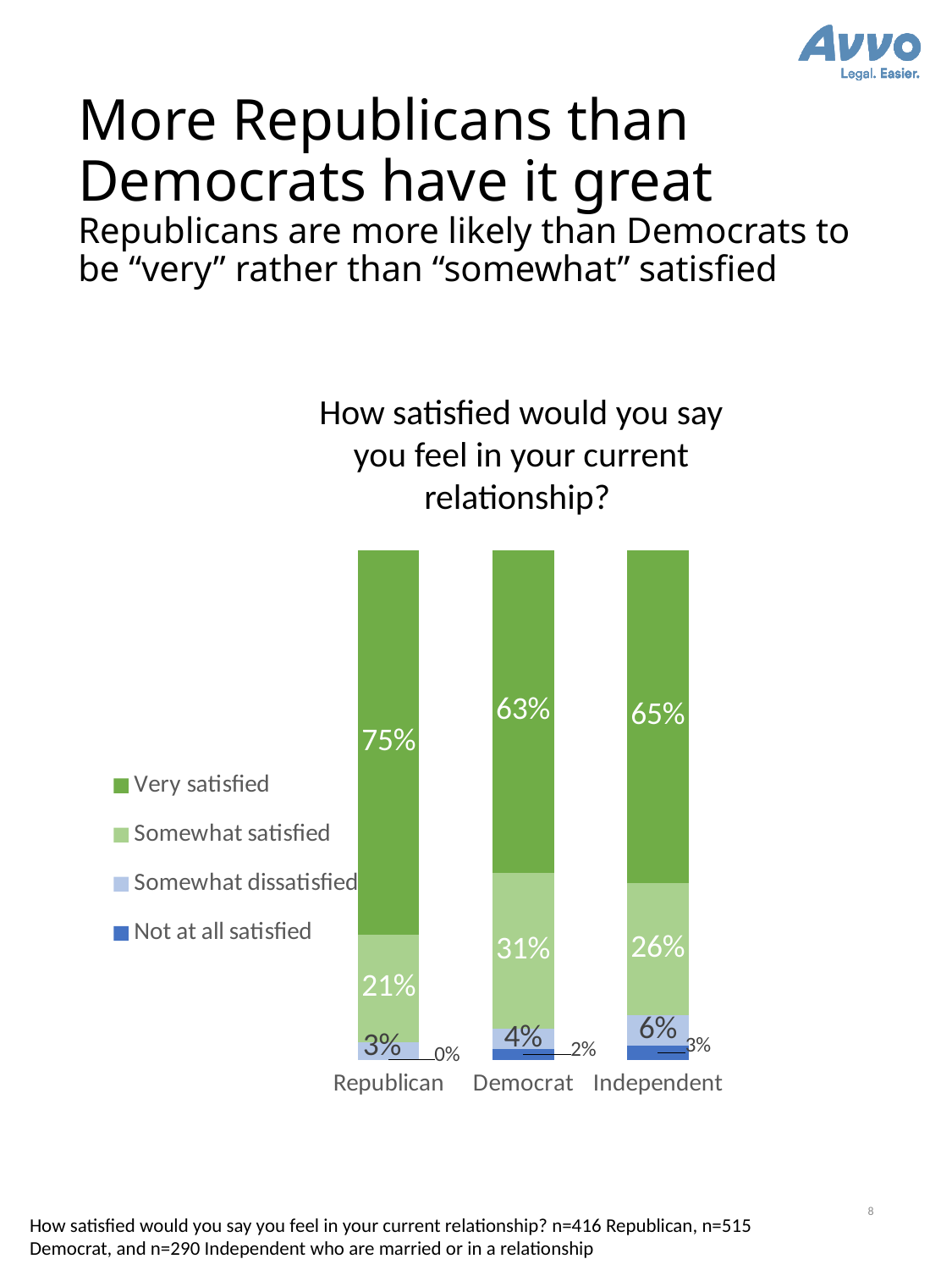
What percentage of Democrats are not at all satisfied? 2% Which group has the lowest share of not at all satisfied respondents? Republican What kind of chart is shown on the slide? Stacked bar chart Is the somewhat satisfied share larger for Democrats or for Independents? Democrats How many groups are shown on the x axis? 3 How many series does the legend list? 4 What percentage of Republicans are very satisfied in their current relationship? 75% What percentage of Independents are somewhat dissatisfied? 6% How many percentage points higher is the very satisfied share for Republicans than for Democrats? 12 What is the title of the chart? How satisfied would you say you feel in your current relationship? Which group has the highest share of very satisfied respondents? Republican What percentage of Democrats are somewhat satisfied? 31%